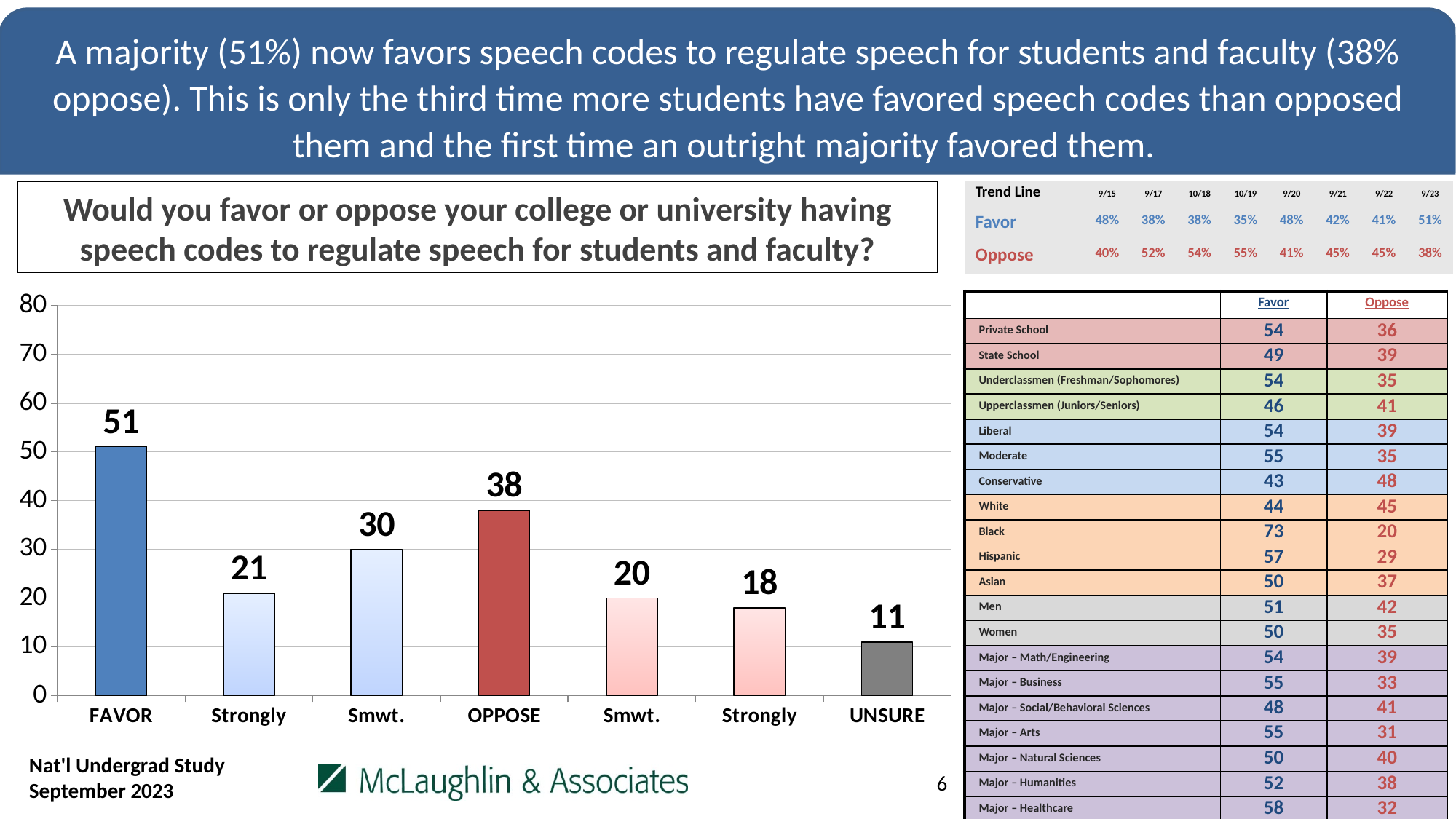
Which category has the lowest bar? UNSURE What is the highest value shown on the vertical axis of the chart? 80 How many bars are shown in the chart? 7 What is the value of the Smwt. bar immediately to the right of OPPOSE? 20 What is the value of the OPPOSE bar? 38 Which is larger, the Smwt. bar to the right of FAVOR or the Smwt. bar to the right of OPPOSE? Smwt. to the right of FAVOR What is the value of the second bar from the left (Strongly, next to FAVOR)? 21 Which category has the highest bar? FAVOR What is the value of the FAVOR bar? 51 What type of chart is shown on the slide? bar chart What is the difference between the FAVOR bar and the OPPOSE bar? 13 What is the value of the UNSURE bar? 11